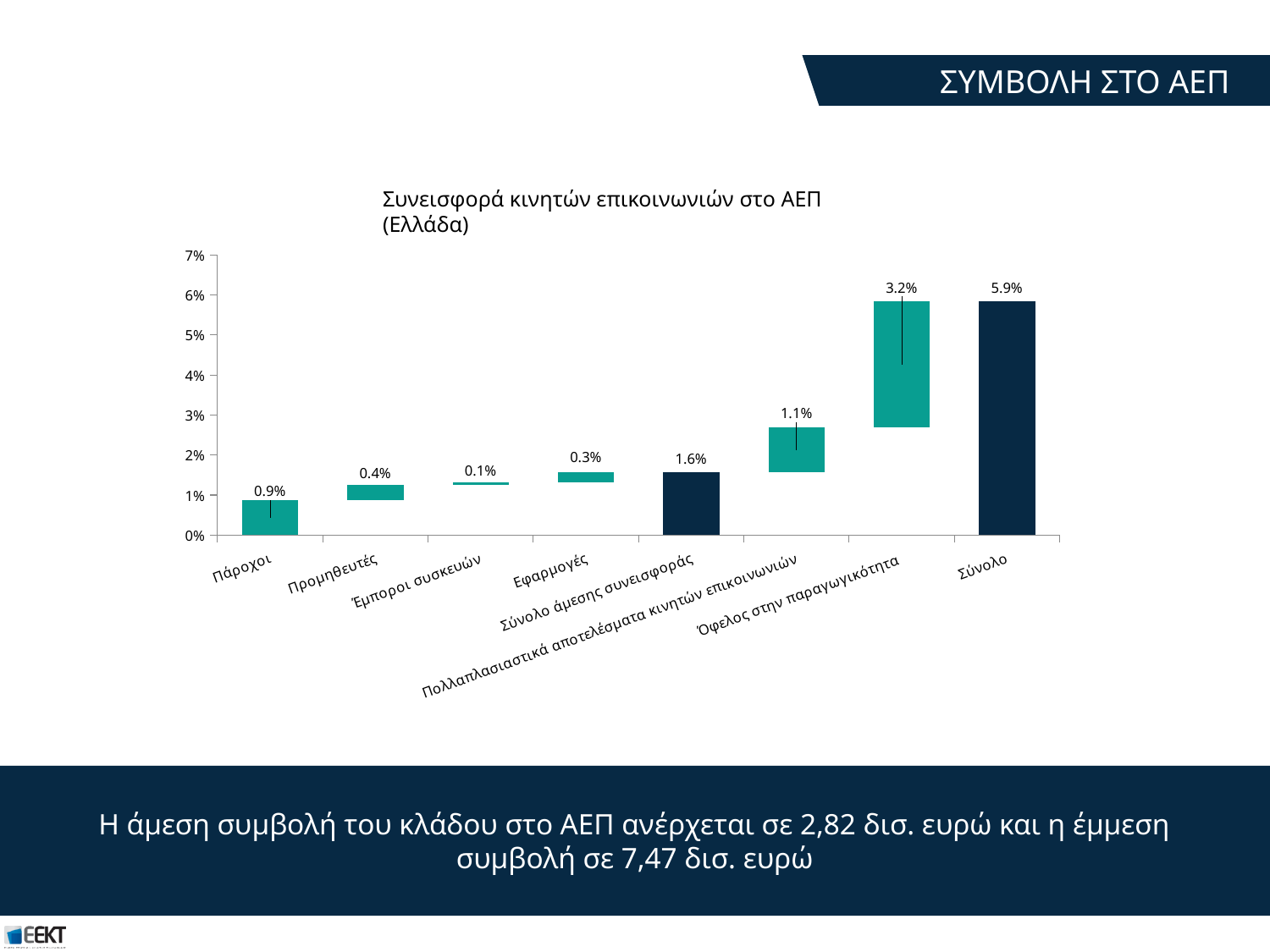
What is the difference between the labelled values for Σύνολο and Σύνολο άμεσης συνεισφοράς? 4.3 percentage points Which category has the highest labelled value? Σύνολο What is the title of the chart? Συνεισφορά κινητών επικοινωνιών στο ΑΕΠ (Ελλάδα) What is the value labelled for Πάροχοι? 0.9% Which category has the lowest labelled value? Έμποροι συσκευών What is the value labelled for Πολλαπλασιαστικά αποτελέσματα κινητών επικοινωνιών? 1.1% What is the value labelled for Όφελος στην παραγωγικότητα? 3.2% How many categories are shown on the x axis? 8 What is the value labelled for Σύνολο άμεσης συνεισφοράς? 1.6% Which has the larger labelled value, Πάροχοι or Προμηθευτές? Πάροχοι What kind of chart is shown on the slide? Bar chart Is the top of the Σύνολο bar greater or less than 5%? greater